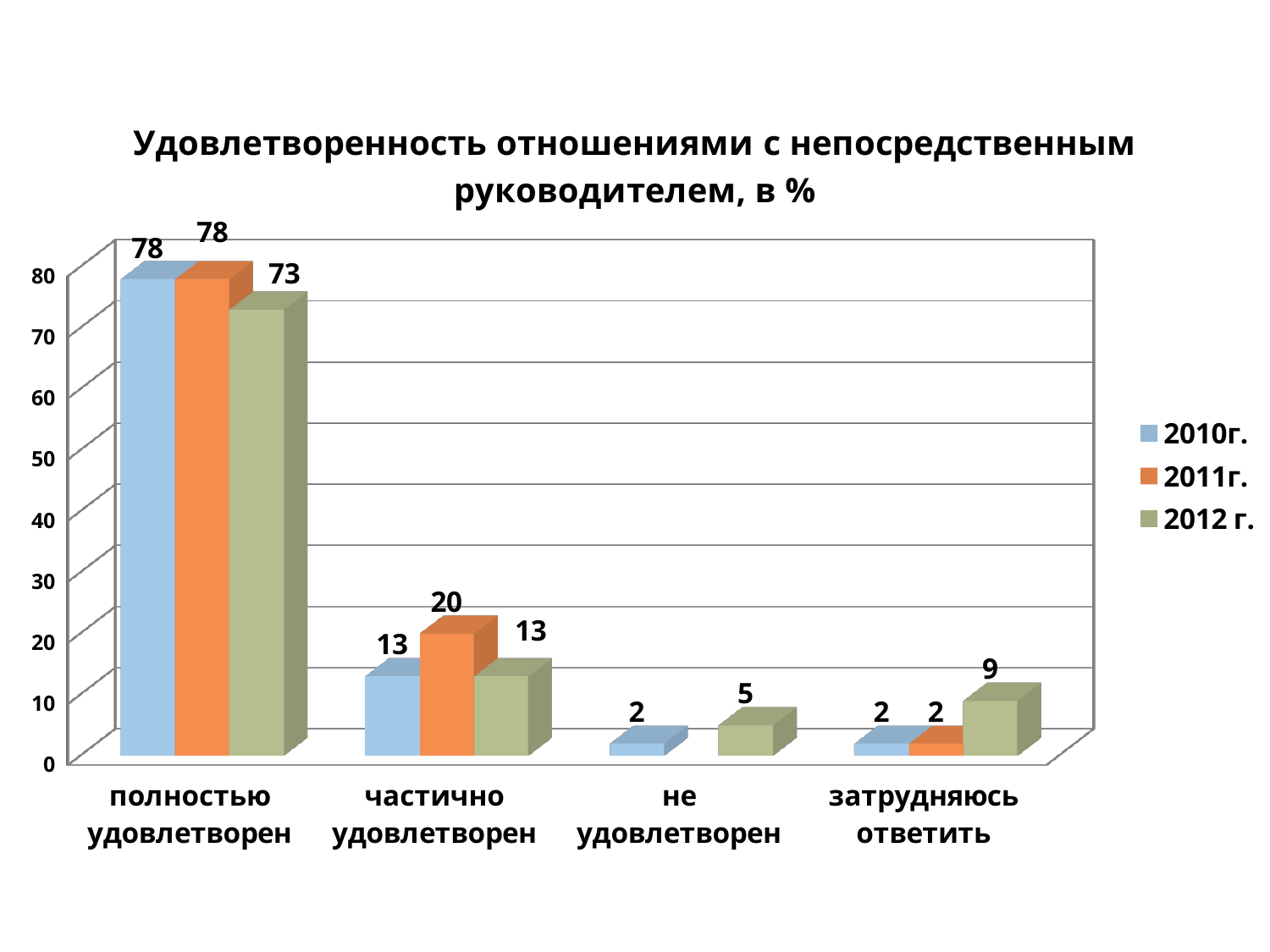
What is the value for 2011г. in the category «частично удовлетворен»? 20 What kind of chart is shown on the slide? bar chart What is the difference between the 2010г. and 2012 г. values for «полностью удовлетворен»? 5 How many series does the legend list? 3 What is the title of the chart? Удовлетворенность отношениями с непосредственным руководителем, в % What is the value for 2010г. in the category «не удовлетворен»? 2 How many categories are shown on the x axis? 4 Which is larger in the category «частично удовлетворен»: the value for 2011г. or the value for 2012 г.? 2011г. Which category has the lowest value for 2012 г.? не удовлетворен What is the value for 2012 г. in the category «затрудняюсь ответить»? 9 Which category has the highest value for 2010г.? полностью удовлетворен What is the value for 2012 г. in the category «полностью удовлетворен»? 73